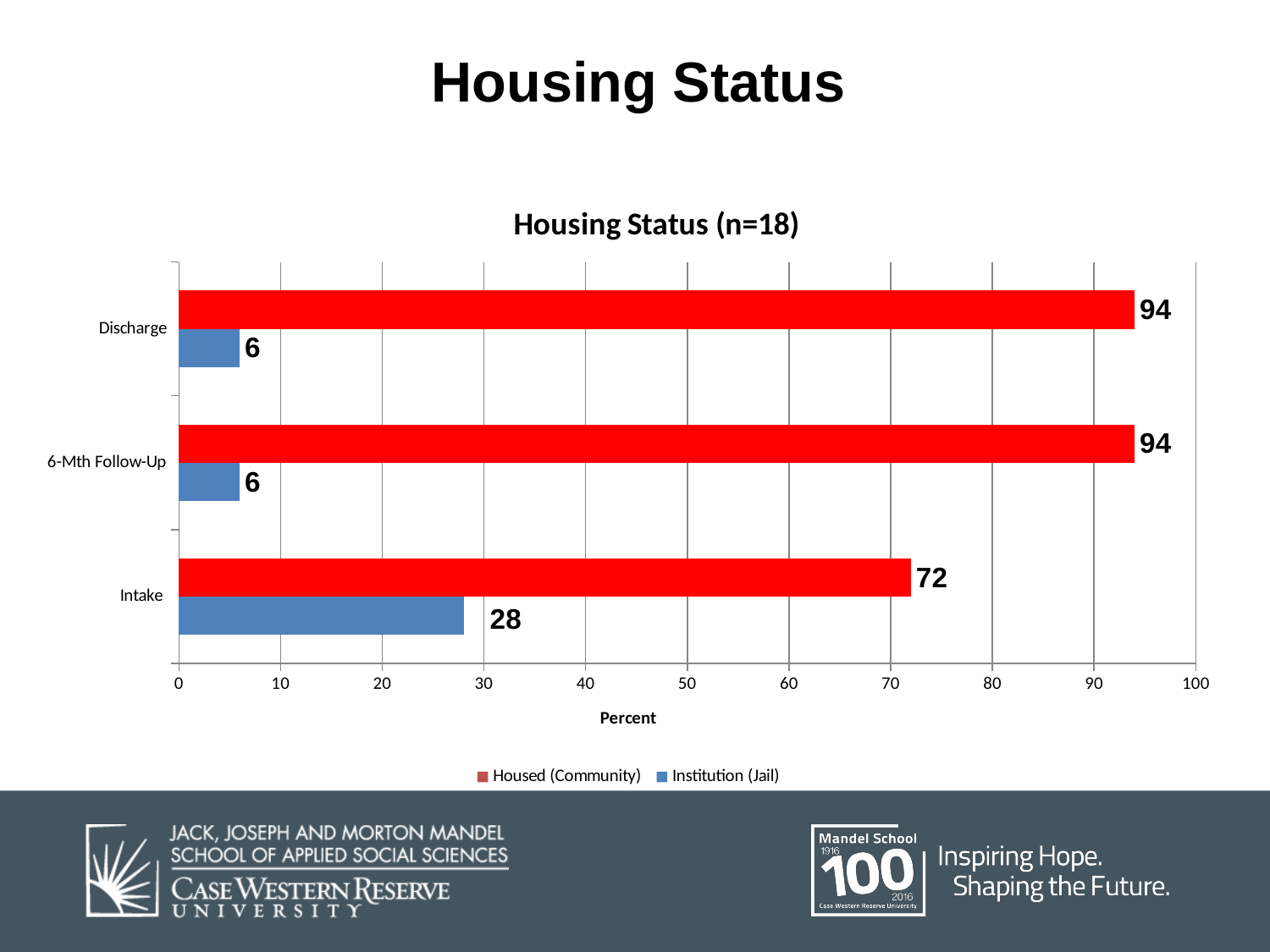
What is the Housed (Community) value for Discharge? 94 What is the title of the chart? Housing Status (n=18) What is the Institution (Jail) value at 6-Mth Follow-Up? 6 How many series does the legend list? 2 Which category has the lowest Housed (Community) value? Intake Which category has the highest Institution (Jail) value? Intake Which is larger at Intake: Housed (Community) or Institution (Jail)? Housed (Community) What kind of chart is shown? Bar chart What is the difference between the Housed (Community) values for Discharge and Intake? 22 How many categories are shown on the chart? 3 What is the Housed (Community) value for Intake? 72 What is the Institution (Jail) value for Intake? 28